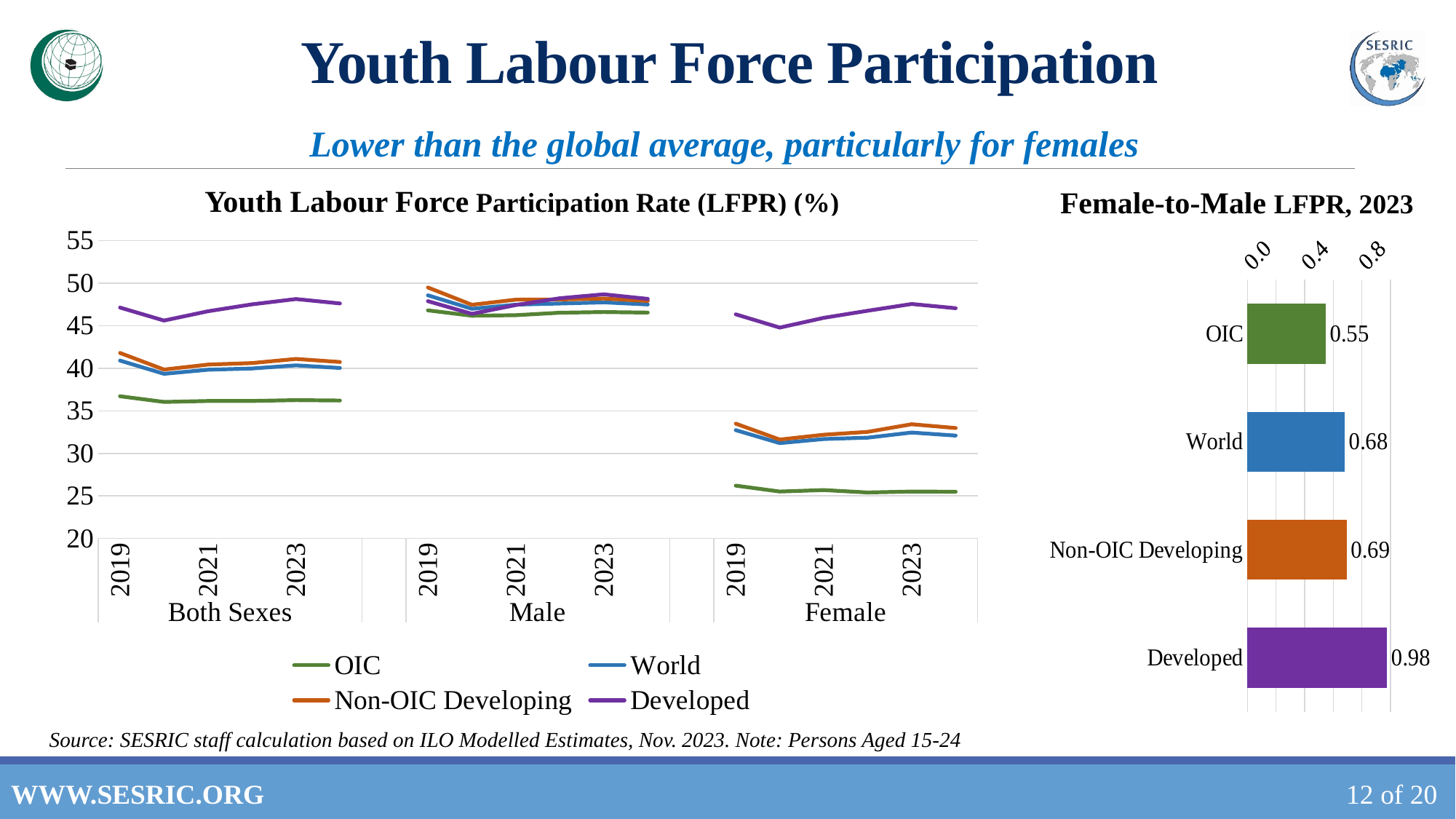
In the 'Female-to-Male LFPR, 2023' chart, what is the value for Developed? 0.98 In the 'Youth Labour Force Participation Rate (LFPR) (%)' chart, which series is lowest in the Female panel? OIC How many series does the legend of the 'Youth Labour Force Participation Rate (LFPR) (%)' chart list? 4 In the 'Female-to-Male LFPR, 2023' chart, what is the difference between the Developed and OIC values? 0.43 In the 'Female-to-Male LFPR, 2023' chart, what is the value for World? 0.68 In the 'Female-to-Male LFPR, 2023' chart, how many categories are shown? 4 In the 'Female-to-Male LFPR, 2023' chart, which category has the highest value? Developed In the 'Female-to-Male LFPR, 2023' chart, what is the value for OIC? 0.55 In the 'Youth Labour Force Participation Rate (LFPR) (%)' chart, is the Developed value for Both Sexes in 2023 greater or less than 45? greater In the 'Youth Labour Force Participation Rate (LFPR) (%)' chart, is the OIC value for Female in 2023 greater or less than 30? less In the 'Female-to-Male LFPR, 2023' chart, which category has the lowest value? OIC What kind of chart is the 'Female-to-Male LFPR, 2023' chart? Bar chart